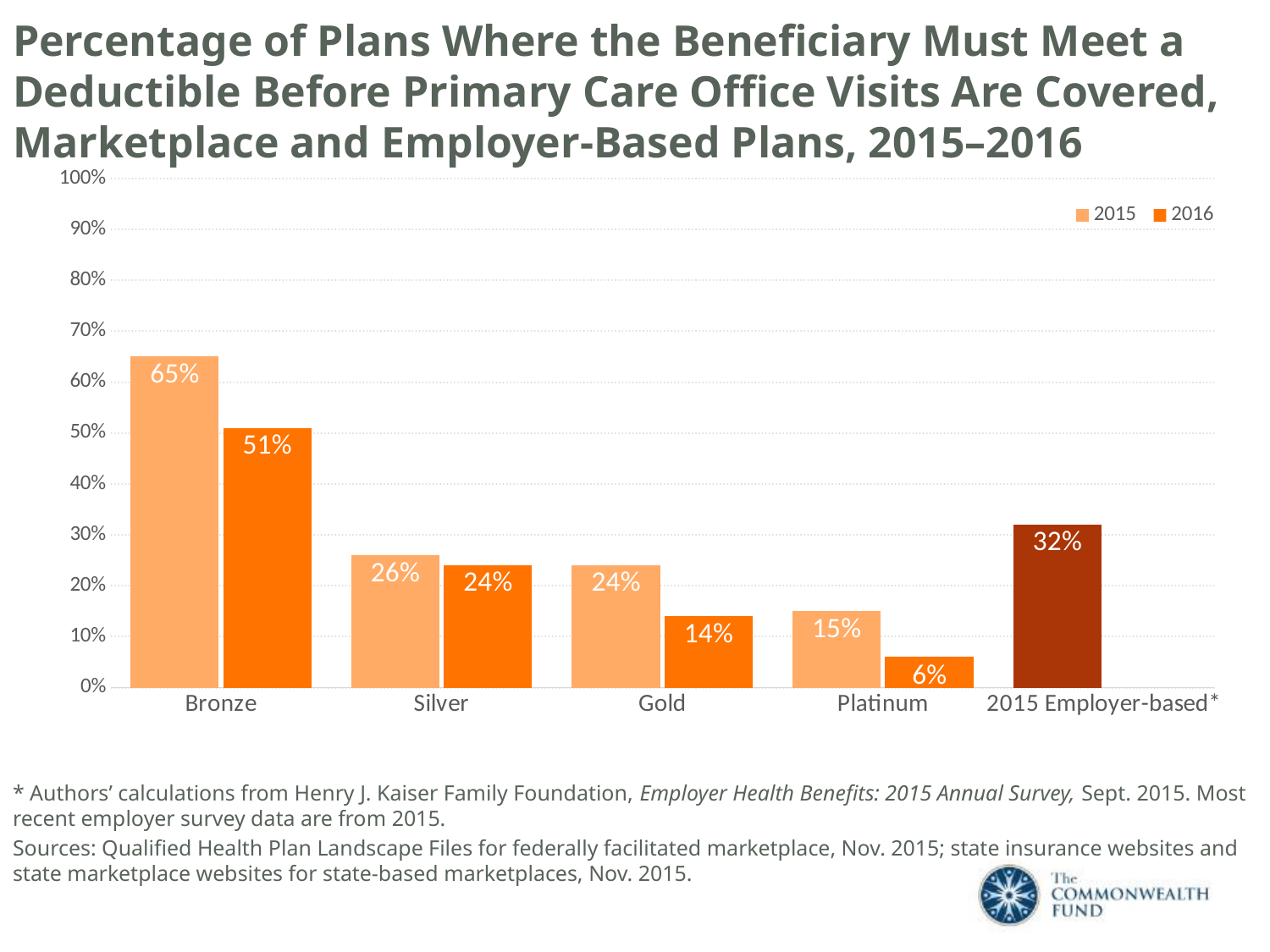
Which is larger: the 2016 value for Silver or the 2015 value for Gold? They are equal (24%) What is the difference between the 2015 and 2016 values for Bronze plans? 14 percentage points What is the 2016 value for Platinum plans? 6% What is the value shown for 2015 Employer-based plans? 32% What kind of chart is shown on the slide? Bar chart Which plan category has the lowest 2015 value among the marketplace tiers? Platinum Do the 2016 values rise or fall moving from Bronze to Platinum along the x axis? Fall Is the 2015 value for Bronze greater or less than 60%? greater What is the 2015 value for Bronze plans? 65% What is the difference between the 2015 and 2016 values for Gold plans? 10 percentage points How many series does the legend list? 2 Which plan category has the highest 2016 value? Bronze